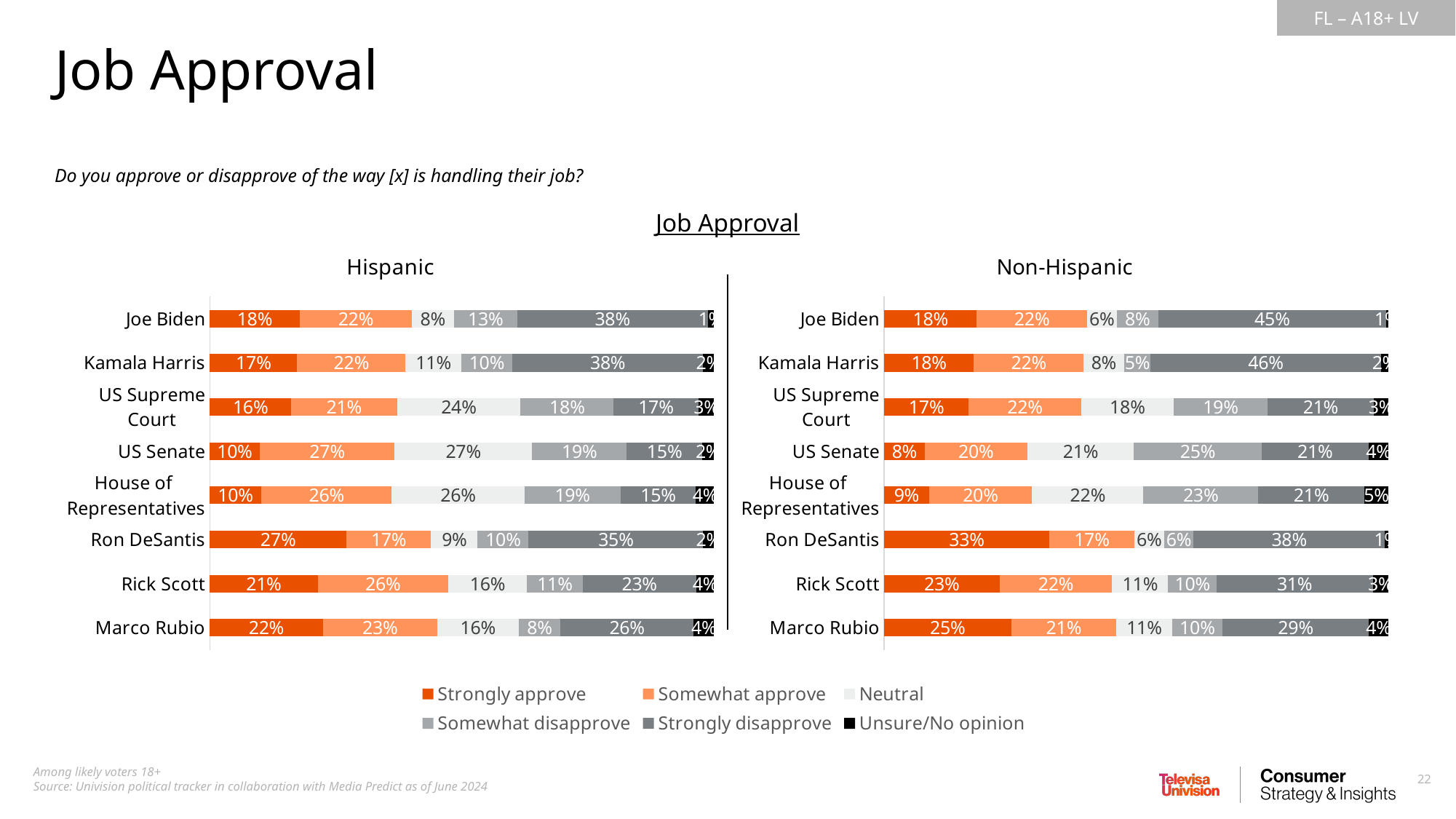
In the Non-Hispanic chart, which entity has the highest Strongly approve percentage? Ron DeSantis In the Hispanic chart, what is the combined Strongly approve and Somewhat approve percentage for Marco Rubio? 45% What type of chart is used to show job approval on this slide? Stacked bar chart How many entities are rated in the Hispanic chart? 8 In the Hispanic chart, what is the Neutral percentage for the US Senate? 27% How many series does the legend list? 6 In the Hispanic chart, is the Strongly approve percentage higher for Marco Rubio or Rick Scott? Marco Rubio In the Non-Hispanic chart, what percentage strongly disapprove of Kamala Harris? 46% In the Non-Hispanic chart, what is the difference between the Strongly disapprove percentages for Joe Biden and Ron DeSantis? 7% In the Non-Hispanic chart, what percentage somewhat disapprove of the House of Representatives? 23% In the Hispanic chart, what percentage strongly approve of Ron DeSantis? 27% In the Hispanic chart, which entity has the lowest Strongly approve percentage? US Senate and House of Representatives (10%)